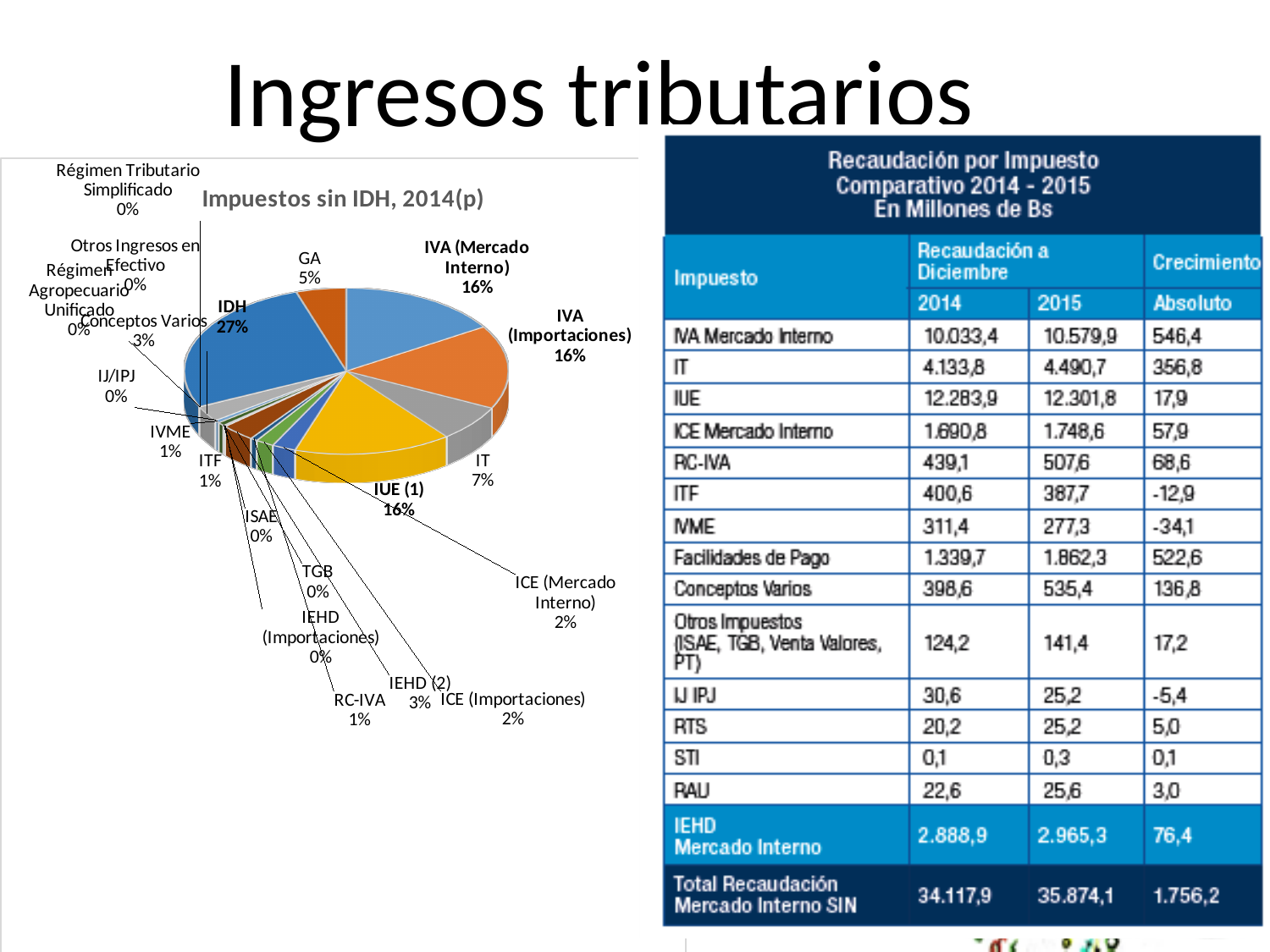
In the pie chart, what is the difference in percentage points between IDH and IT? 20 In the pie chart, what share does GA have? 5% In the pie chart, what share does IT have? 7% In the pie chart, what share does IVA (Mercado Interno) have? 16% What type of chart is shown on the left of the slide? pie chart In the pie chart, what share does RC-IVA have? 1% In the pie chart, which is larger, IT or GA? IT In the pie chart, what share does IDH have? 27% In the pie chart, what share does IEHD (2) have? 3% Which category has the largest slice in the pie chart? IDH What is the title of the pie chart? Impuestos sin IDH, 2014(p) In the pie chart, what share does ICE (Mercado Interno) have? 2%